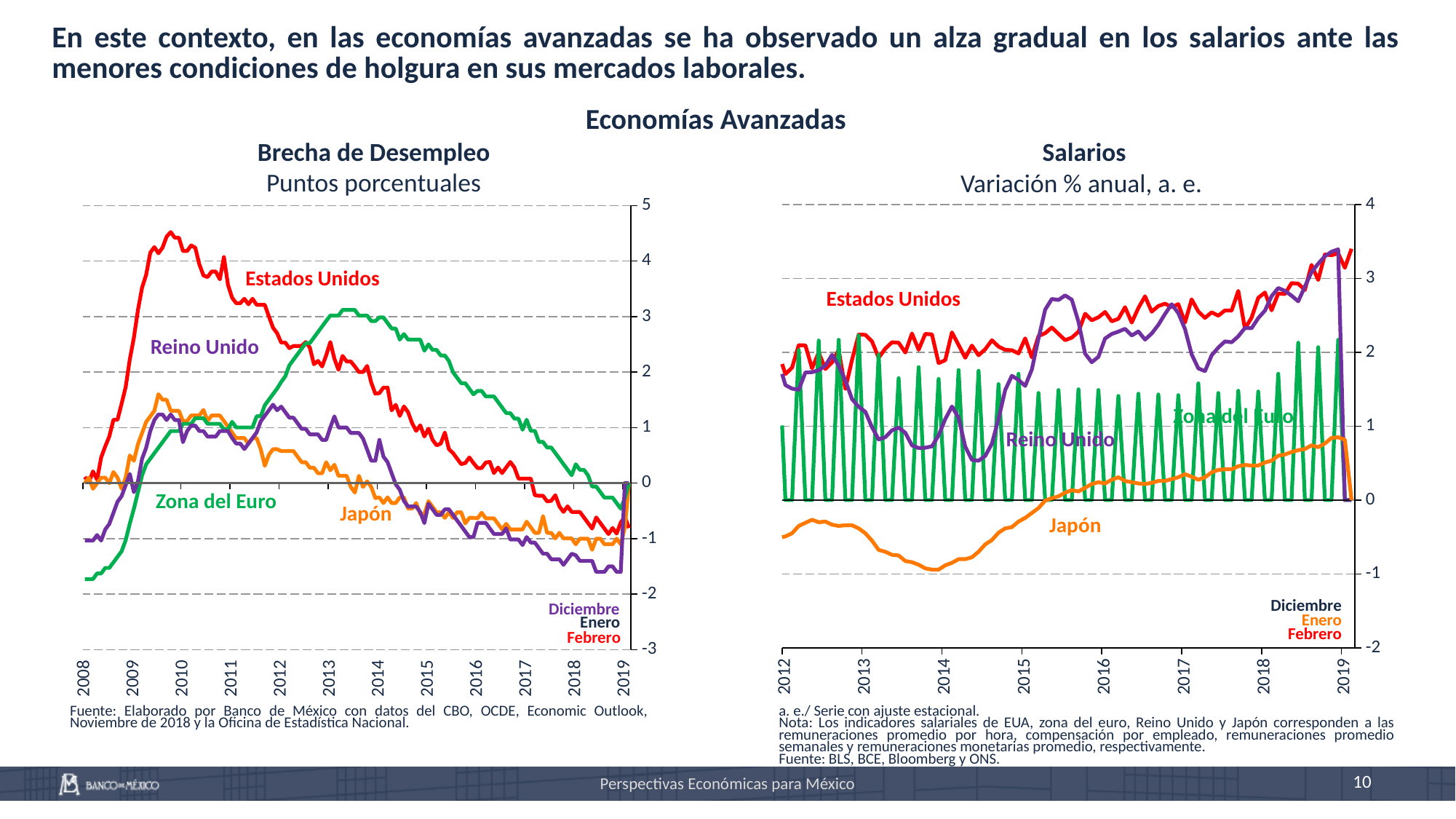
What unit is shown under the title of the 'Salarios' chart? Variación % anual, a. e. In the 'Brecha de Desempleo' chart, is the peak value for Estados Unidos around 2010 greater or less than 4? greater In the 'Salarios' chart, does the Japón series rise or fall from 2014 to 2019? rise In the 'Salarios' chart, is the value for Estados Unidos at the end of 2018 greater or less than 3? greater In the 'Brecha de Desempleo' chart, is the value for Reino Unido at the end of 2018 greater or less than -1? less In the 'Brecha de Desempleo' chart, which series reaches the highest value around 2010? Estados Unidos In the 'Salarios' chart, which series has the lowest value in 2014? Japón How many series are labelled in the 'Salarios' chart on the right? 4 In the 'Brecha de Desempleo' chart, which series has the highest value in 2013? Zona del Euro What kind of chart is the 'Brecha de Desempleo' chart on the left? line chart In the 'Brecha de Desempleo' chart, does the Estados Unidos series rise or fall from 2010 to 2019? fall